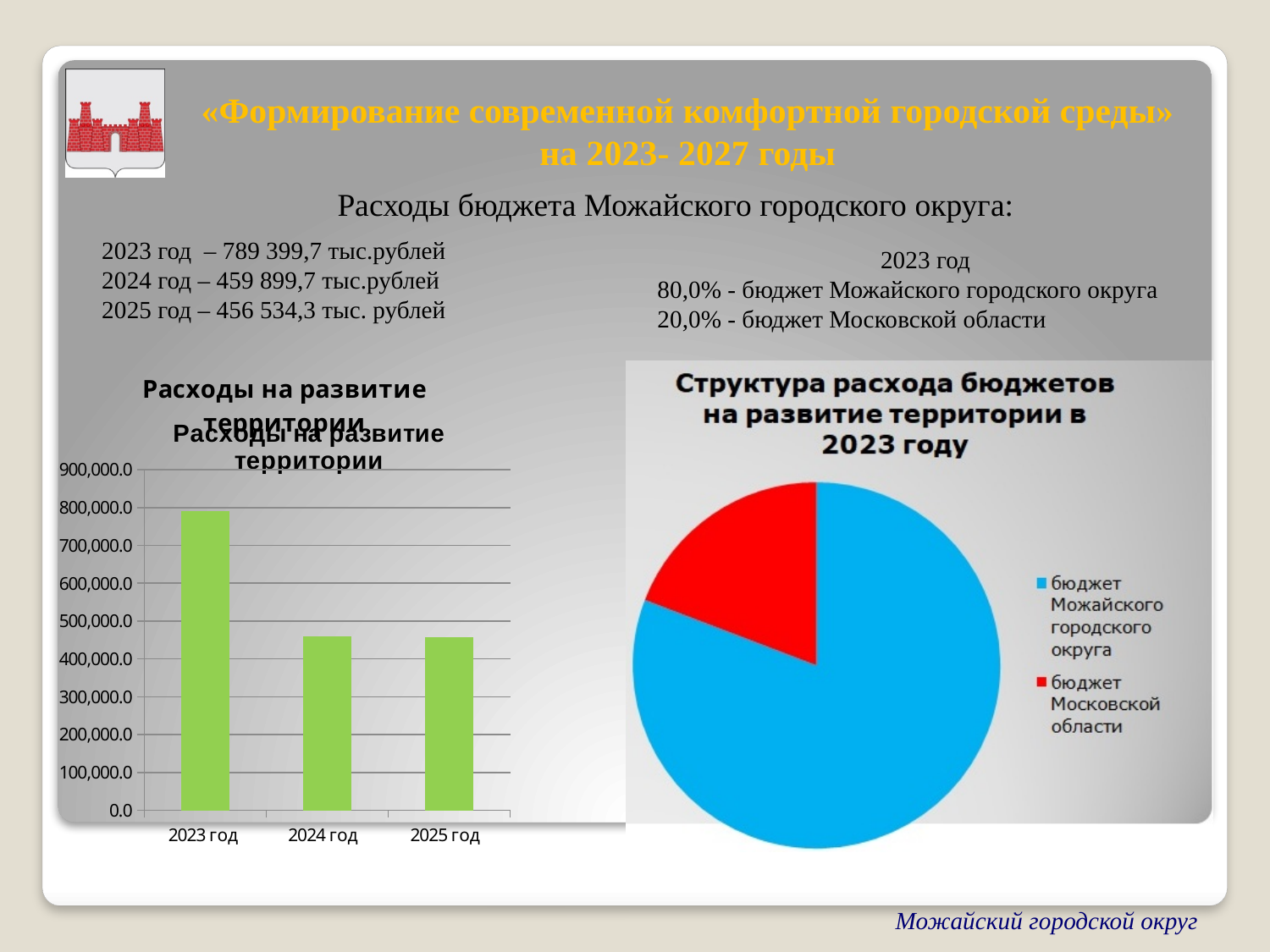
In the bar chart «Расходы на развитие территории», how many years are shown on the x axis? 3 In the bar chart «Расходы на развитие территории», which year has the highest value? 2023 год In the pie chart «Структура расхода бюджетов на развитие территории в 2023 году», what share does «бюджет Московской области» have? 20,0% In the bar chart «Расходы на развитие территории», do the values rise or fall from 2023 год to 2025 год? fall In the pie chart «Структура расхода бюджетов на развитие территории в 2023 году», how many entries does the legend list? 2 In the bar chart «Расходы на развитие территории», is the value for 2023 год greater or less than 700,000.0? greater What kind of chart is the chart titled «Расходы на развитие территории»? bar chart In the pie chart «Структура расхода бюджетов на развитие территории в 2023 году», which slice is the largest? бюджет Можайского городского округа In the bar chart «Расходы на развитие территории», is the value for 2024 год greater or less than 500,000.0? less In the bar chart «Расходы на развитие территории», which is larger, the value for 2023 год or the value for 2025 год? 2023 год What kind of chart is the chart titled «Структура расхода бюджетов на развитие территории в 2023 году»? pie chart In the bar chart «Расходы на развитие территории», is the value for 2025 год greater or less than 400,000.0? greater